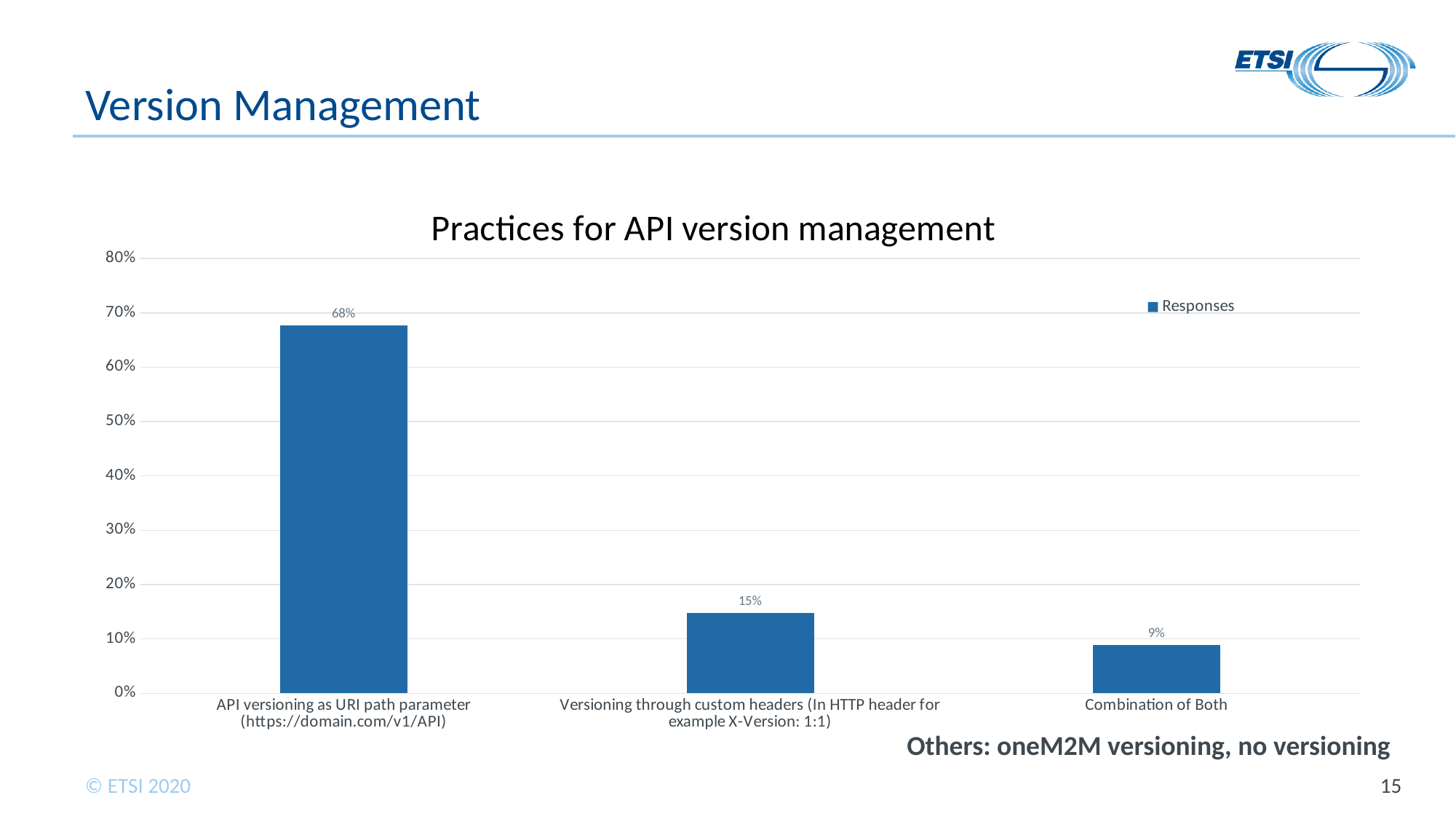
What kind of chart is shown on the slide? bar chart What is the value for 'Combination of Both'? 9% Is the value for 'API versioning as URI path parameter' greater or less than 60%? greater What is the value for 'API versioning as URI path parameter (https://domain.com/v1/API)'? 68% How many categories are shown on the x axis? 3 What is the value for 'Versioning through custom headers (In HTTP header for example X-Version: 1:1)'? 15% Which category has the lowest value? Combination of Both What is the difference between the value for 'API versioning as URI path parameter' and the value for 'Versioning through custom headers'? 53% Which is larger: the value for 'Versioning through custom headers' or the value for 'Combination of Both'? Versioning through custom headers Which category has the highest value? API versioning as URI path parameter (https://domain.com/v1/API) How many series does the legend list? 1 What is the difference between the value for 'Versioning through custom headers' and the value for 'Combination of Both'? 6%